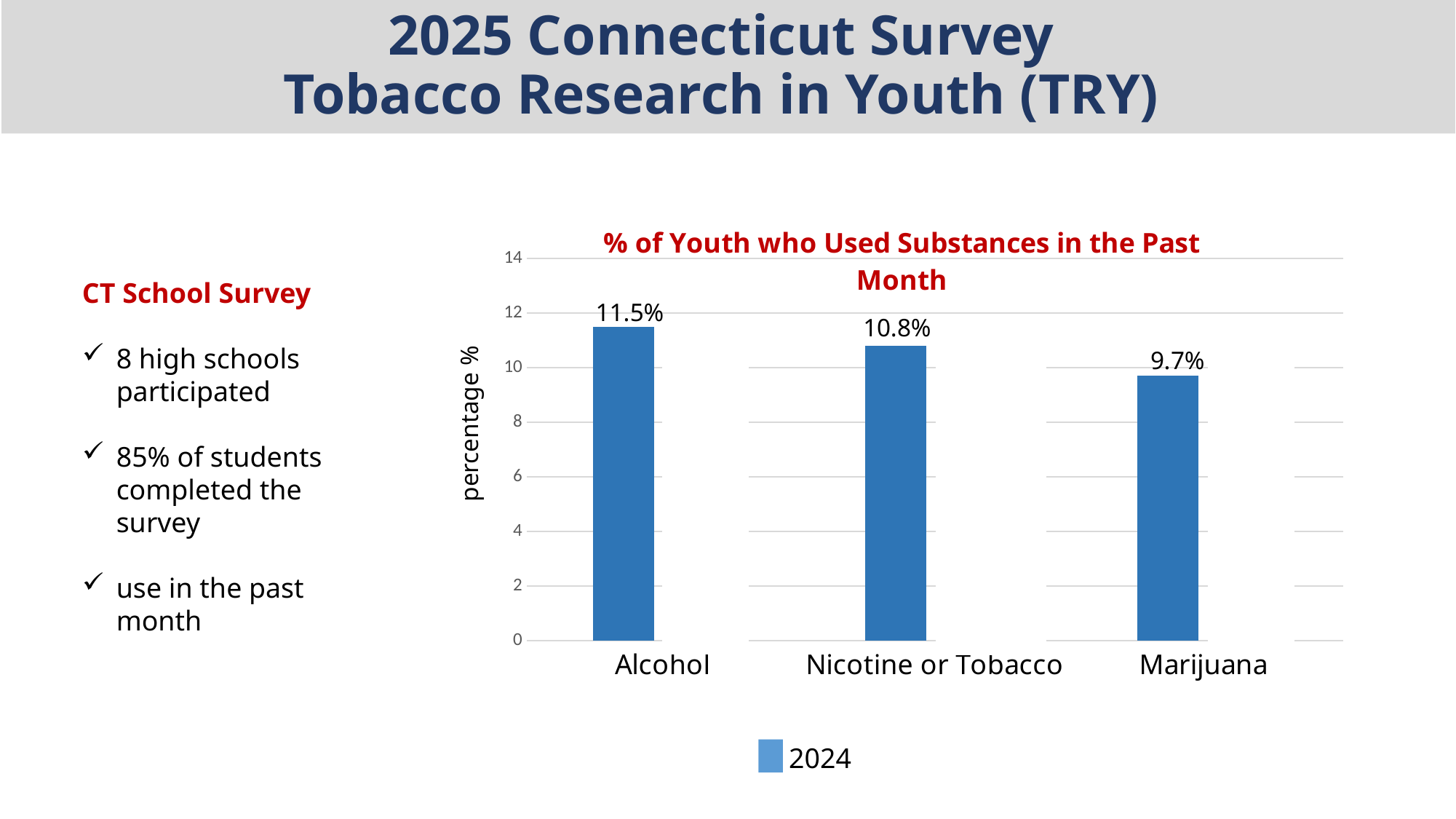
What is the difference between the percentage for Alcohol and the percentage for Nicotine or Tobacco? 0.7% What year does the chart legend list? 2024 How many substance categories are shown in the chart? 3 What percentage of youth used marijuana in the past month? 9.7% Which substance has the highest percentage of youth use in the past month? Alcohol Is the value for Marijuana greater or less than 10? less Which is larger, the percentage for Nicotine or Tobacco or the percentage for Marijuana? Nicotine or Tobacco Which substance has the lowest percentage of youth use in the past month? Marijuana What percentage of youth used nicotine or tobacco in the past month? 10.8% What percentage of youth used alcohol in the past month? 11.5% What is the difference between the percentage for Alcohol and the percentage for Marijuana? 1.8% What kind of chart is shown on the slide? Bar chart